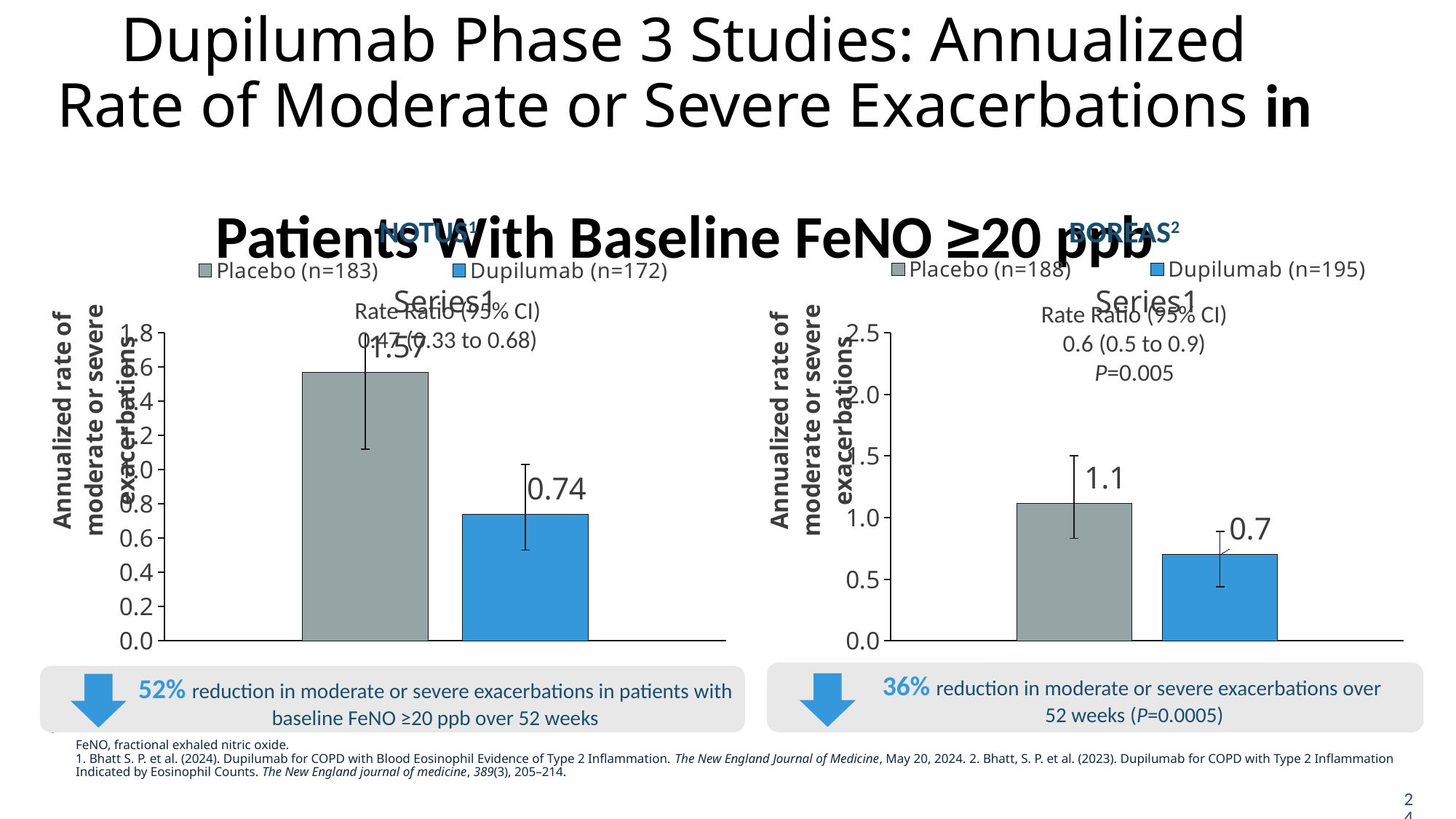
How many bars are plotted in the left chart (NOTUS)? 2 In the left chart (NOTUS), which group has the lowest annualized exacerbation rate? Dupilumab (n=172) In the left chart (NOTUS), what is the annualized exacerbation rate for Dupilumab (n=172)? 0.74 In the right chart (BOREAS), what is the difference between the Placebo and Dupilumab rates? 0.4 In the right chart (BOREAS), what is the annualized exacerbation rate for Dupilumab (n=195)? 0.7 In the left chart (NOTUS), what is the annualized exacerbation rate for Placebo (n=183)? 1.57 How many series does the legend of the right chart (BOREAS) list? 2 In the right chart (BOREAS), what is the annualized exacerbation rate for Placebo (n=188)? 1.1 In the right chart (BOREAS), what colour is the Dupilumab bar? Blue What type of chart is the left chart (NOTUS)? Bar chart In the left chart (NOTUS), is the value for Placebo greater or less than 1.4? greater In the right chart (BOREAS), which group has the higher annualized exacerbation rate, Placebo or Dupilumab? Placebo